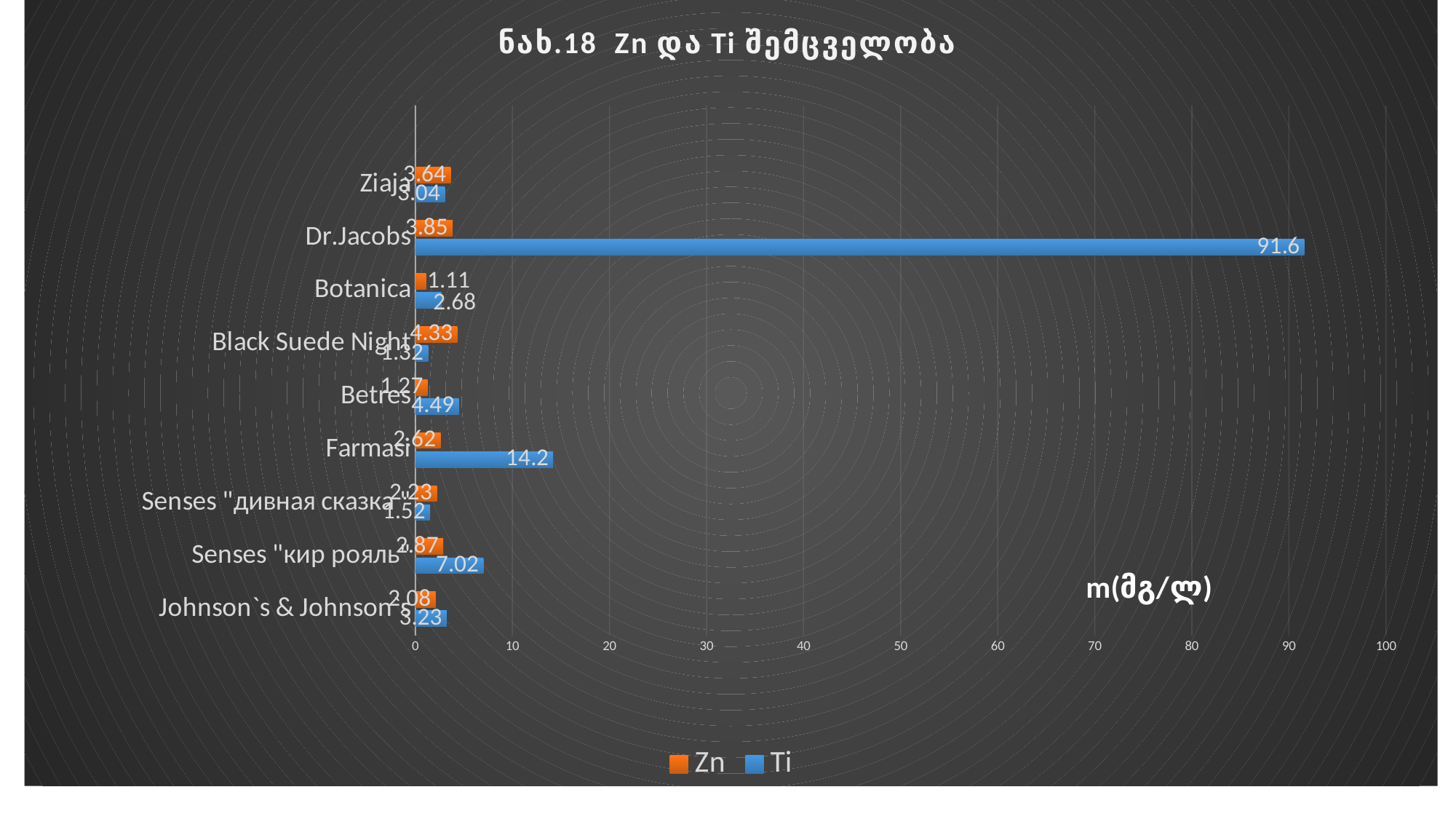
What is the Ti value for Dr.Jacobs? 91.6 What is the Zn value for Botanica? 1.11 What is the Ti value for Senses "кир рояль"? 7.02 Which is larger for Betres, the Zn value or the Ti value? Ti How many brands (categories) are plotted on the chart? 9 Which brand has the highest Zn value? Black Suede Night What is the difference between the Ti value for Dr.Jacobs and the Ti value for Farmasi? 77.4 How many series does the legend list? 2 Which brand has the highest Ti value? Dr.Jacobs What type of chart is shown on the slide? bar chart What is the Ti value for Farmasi? 14.2 Which brand has the lowest Zn value? Botanica